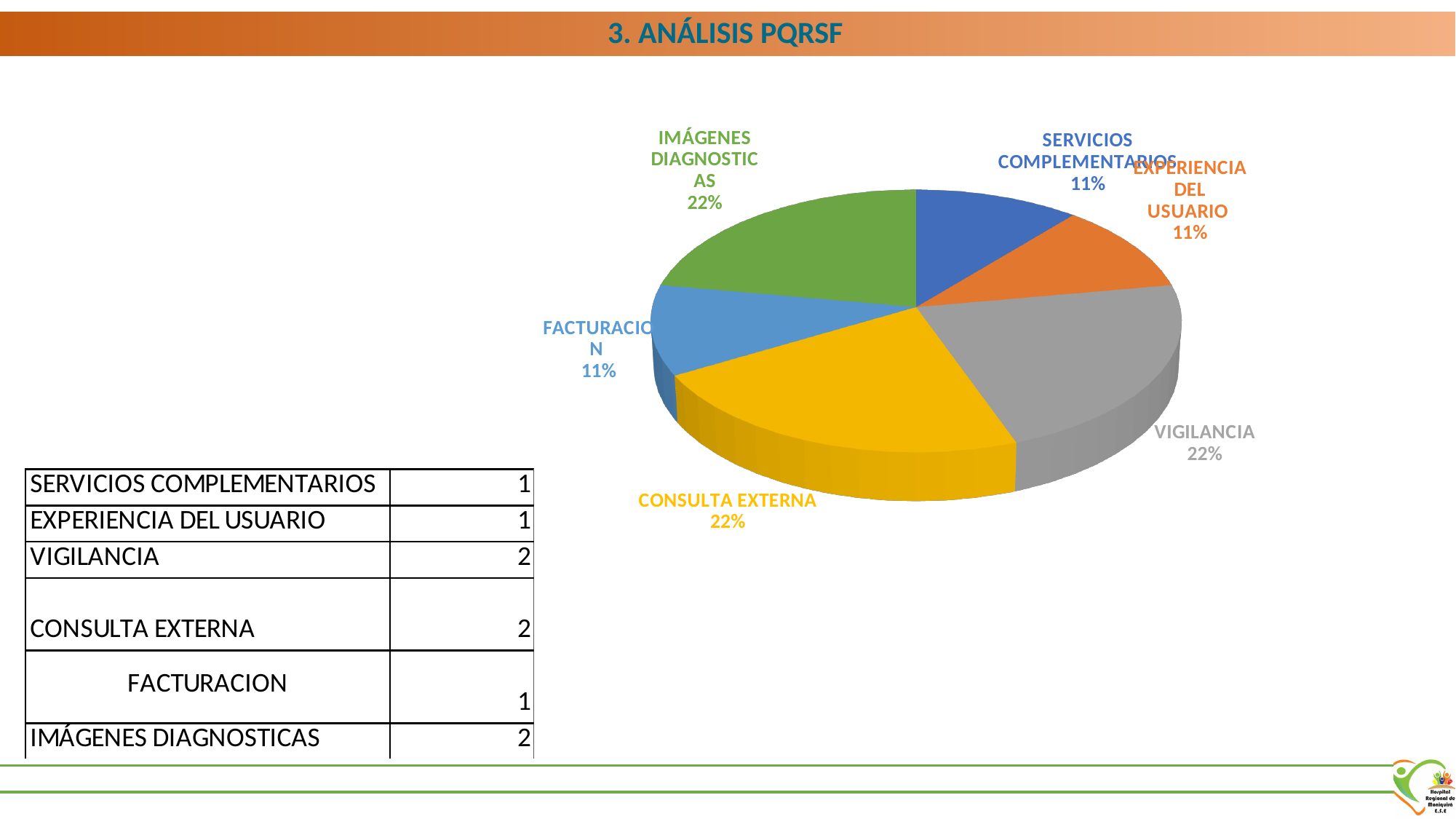
Which slice is larger, VIGILANCIA or EXPERIENCIA DEL USUARIO? VIGILANCIA What share of the pie does EXPERIENCIA DEL USUARIO represent? 11% What share of the pie does FACTURACION represent? 11% What kind of chart is shown on the slide? pie chart How many slices of the pie chart are labelled 22%? 3 What share of the pie does CONSULTA EXTERNA represent? 22% How many slices does the pie chart have? 6 Which slice is larger, FACTURACION or CONSULTA EXTERNA? CONSULTA EXTERNA What colour is the CONSULTA EXTERNA slice of the pie chart? yellow